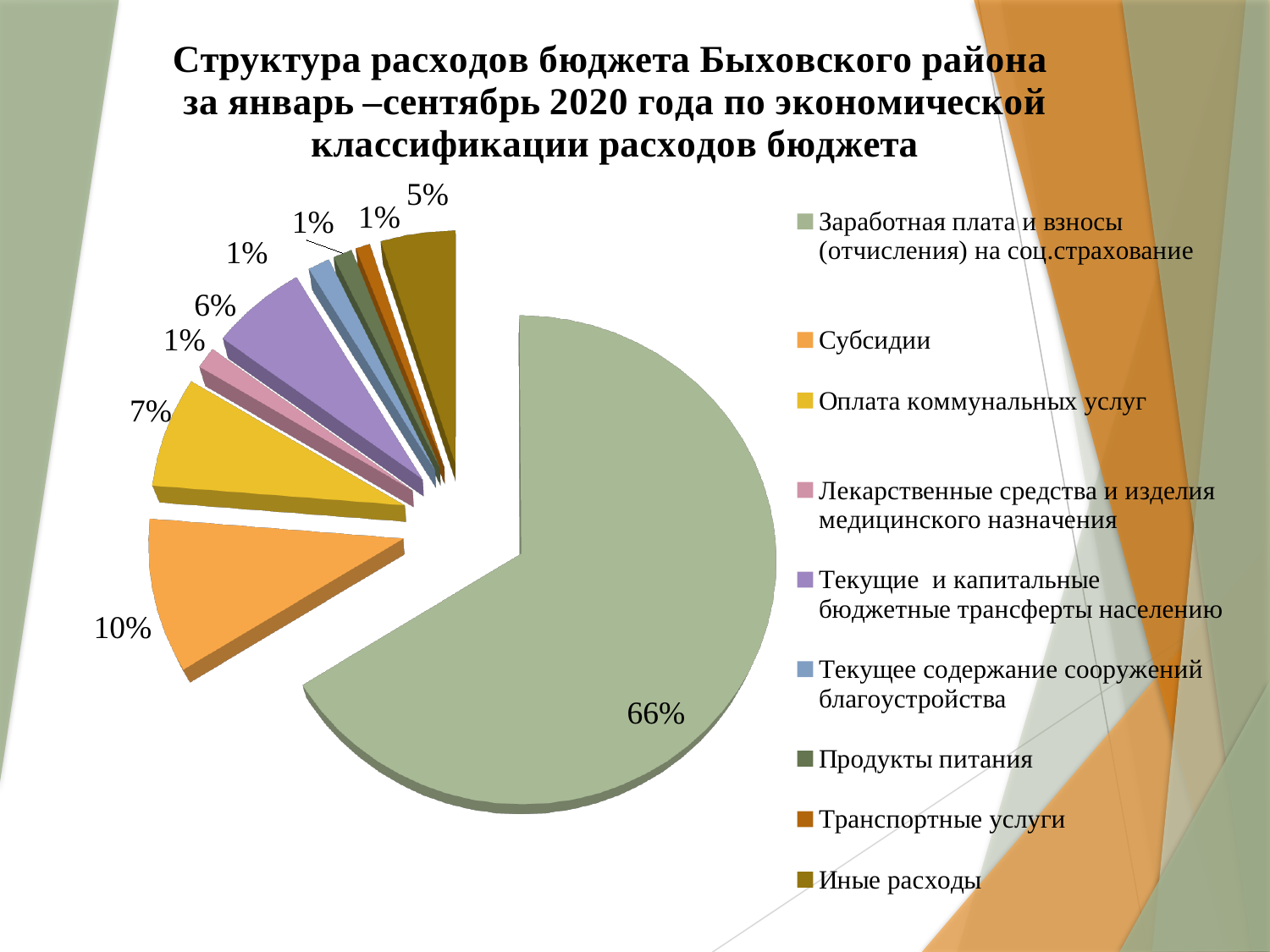
What share of the budget expenditure is for Субсидии? 10% What share of the budget expenditure is for Оплата коммунальных услуг? 7% What colour is the slice for Транспортные услуги? orange-brown How many categories does the legend list? 9 What share of the budget expenditure is for Заработная плата и взносы (отчисления) на соц.страхование? 66% Which is larger: the share for Субсидии or the share for Оплата коммунальных услуг? Субсидии What kind of chart is shown on the slide? pie chart What share of the budget expenditure is for Продукты питания? 1% What is the difference in percentage points between the share for Субсидии and the share for Иные расходы? 5 What share of the budget expenditure is for Иные расходы? 5% What share of the budget expenditure is for Текущие и капитальные бюджетные трансферты населению? 6% Which category has the largest share of the budget expenditure? Заработная плата и взносы (отчисления) на соц.страхование